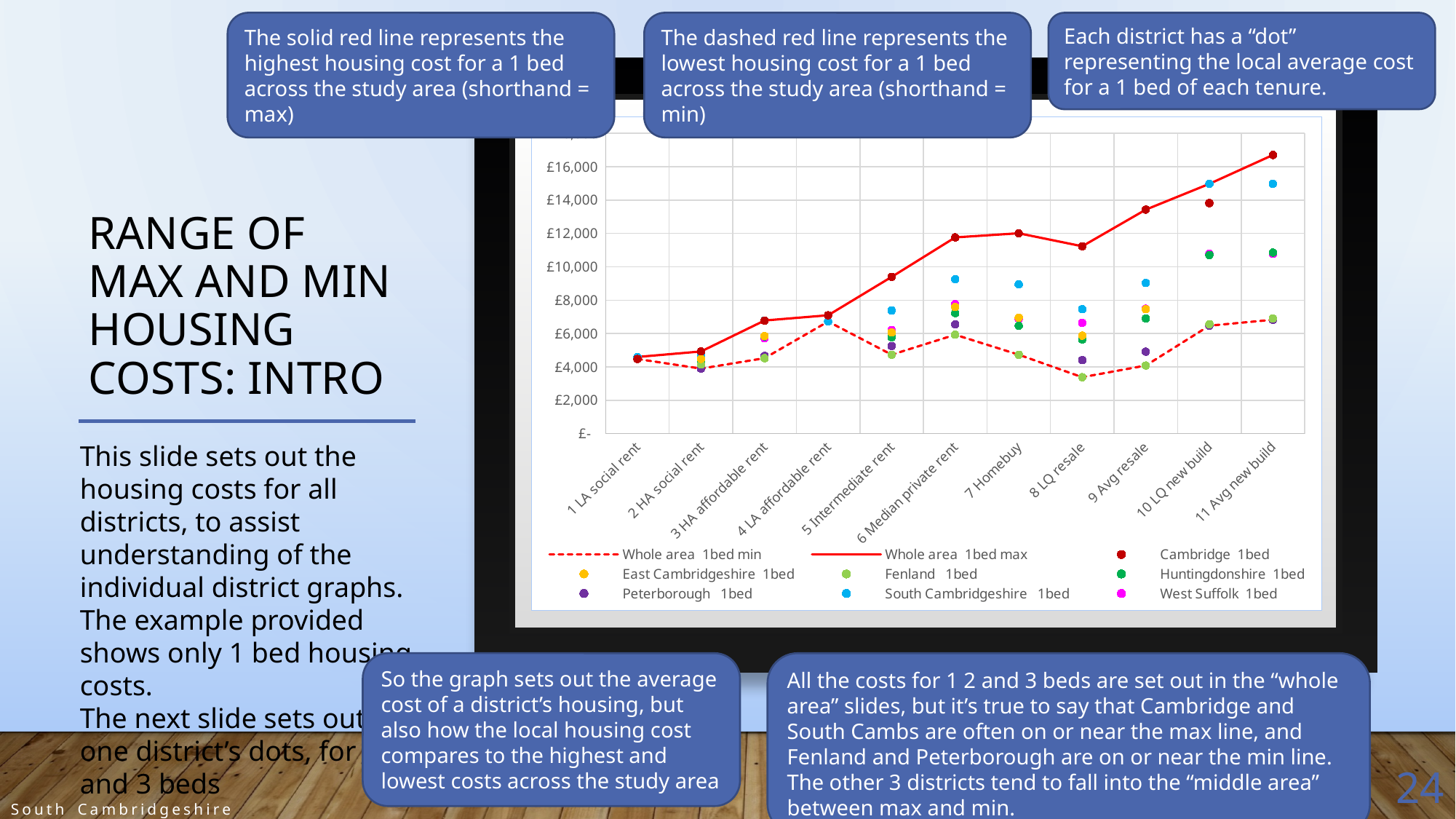
How many series does the chart legend list? 9 For which category does the Whole area 1bed max line reach its highest value? 11 Avg new build At 10 LQ new build, which is higher: the Cambridge 1bed dot or the Fenland 1bed dot? Cambridge 1bed What kind of chart is shown on the slide? line chart Does the Whole area 1bed max line generally rise or fall from 1 LA social rent to 11 Avg new build? rise For which category does the Whole area 1bed min line reach its lowest value? 8 LQ resale Is the Whole area 1bed min value for 8 LQ resale greater or less than £4,000? less Is the Whole area 1bed max value for 11 Avg new build greater or less than £16,000? greater Is the Whole area 1bed max value for 6 Median private rent greater or less than £10,000? greater How many categories are shown on the x axis of the chart? 11 Which series is drawn as a dashed red line in the chart? Whole area 1bed min